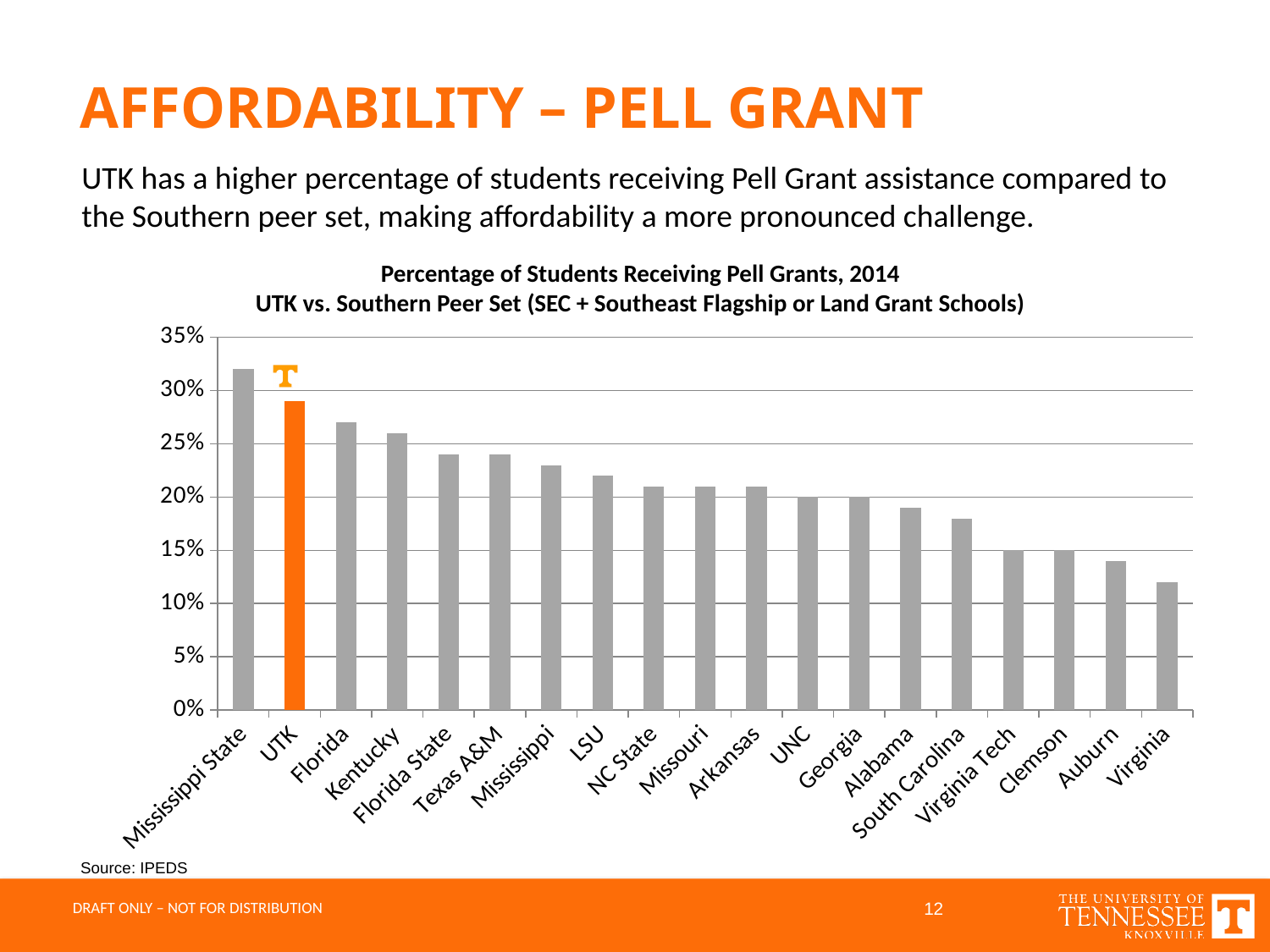
Which has a higher percentage of students receiving Pell Grants, Mississippi State or UTK? Mississippi State Is the value for UTK greater or less than 25%? greater Is the value for Virginia greater or less than 15%? less How many schools are shown on the x axis of the chart? 19 Which school has the lowest percentage of students receiving Pell Grants? Virginia Do the bar values rise or fall moving from left to right along the x axis? fall Is the value for Mississippi State greater or less than 30%? greater Which school's bar is highlighted in orange? UTK What kind of chart is shown on the slide? bar chart Which school has the highest percentage of students receiving Pell Grants? Mississippi State